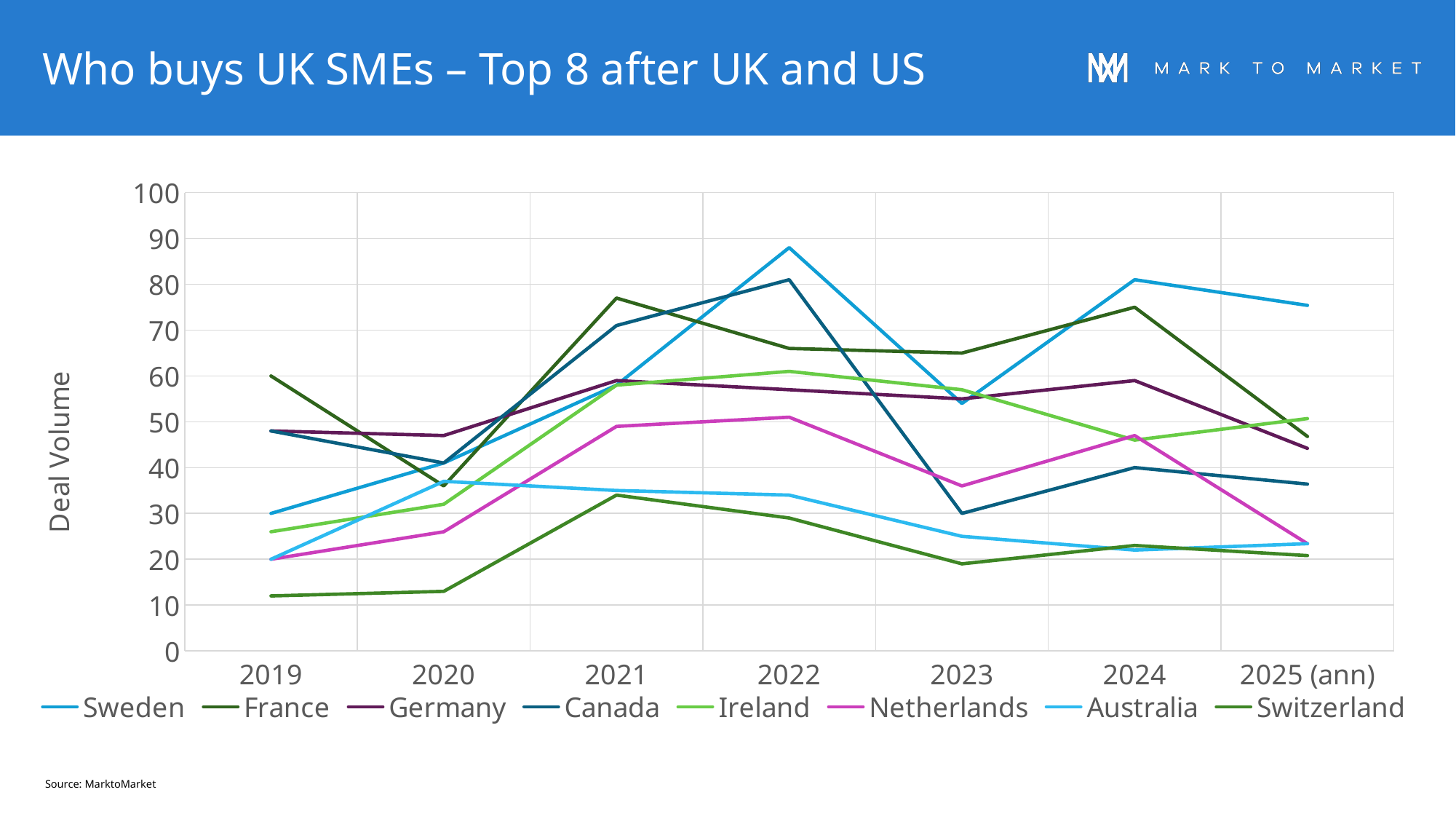
Which series has the highest value in 2019? France What is the title of the y axis? Deal Volume Which series has the lowest value in 2019? Switzerland In 2021, which is larger, the value for France or the value for Netherlands? France What kind of chart is shown on the slide? line chart How many series does the legend list? 8 Is the value for Canada in 2023 greater or less than 40? less How many points are there along the x axis? 7 Does the value for Australia rise or fall from 2020 to 2024? fall Which series reaches the highest point anywhere on the chart? Sweden Is the value for Switzerland in 2019 greater or less than 20? less Is the value for Sweden in 2022 greater or less than 80? greater